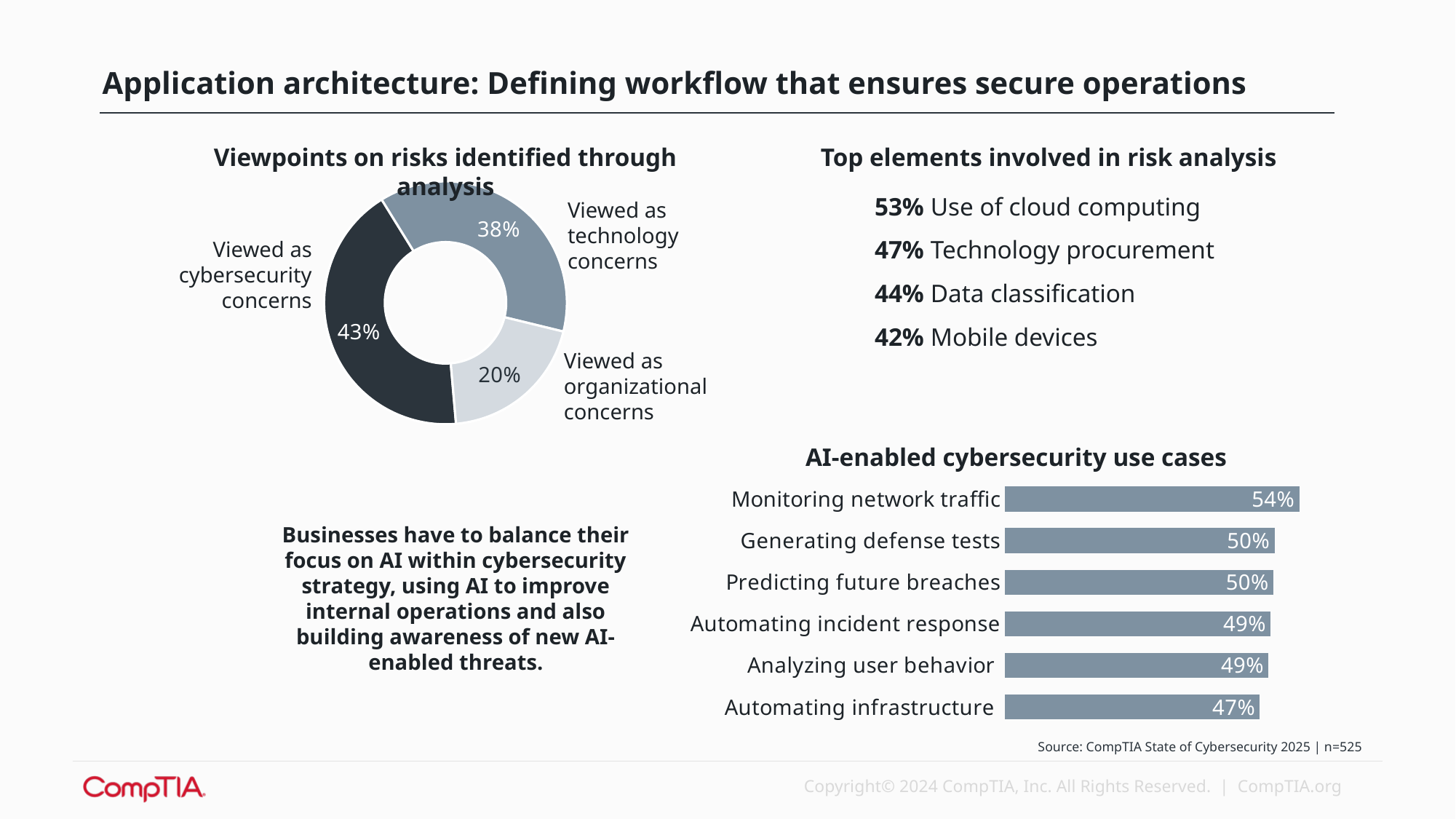
What kind of chart is 'AI-enabled cybersecurity use cases'? Bar chart In the 'AI-enabled cybersecurity use cases' chart, what is the difference between Monitoring network traffic and Automating infrastructure? 7% In the 'Viewpoints on risks identified through analysis' chart, what share is viewed as organizational concerns? 20% In the 'AI-enabled cybersecurity use cases' chart, what is the value for Monitoring network traffic? 54% In the 'AI-enabled cybersecurity use cases' chart, how many use cases are shown? 6 In the 'Viewpoints on risks identified through analysis' chart, which viewpoint has the smallest share? Viewed as organizational concerns In the 'Viewpoints on risks identified through analysis' chart, what share is viewed as cybersecurity concerns? 43% In the 'AI-enabled cybersecurity use cases' chart, which use case has the highest value? Monitoring network traffic What kind of chart is 'Viewpoints on risks identified through analysis'? Donut (pie) chart In the 'AI-enabled cybersecurity use cases' chart, what is the value for Automating infrastructure? 47% In the 'Viewpoints on risks identified through analysis' chart, which viewpoint has the largest share? Viewed as cybersecurity concerns In the 'Viewpoints on risks identified through analysis' chart, what is the difference between the technology concerns share and the organizational concerns share? 18%